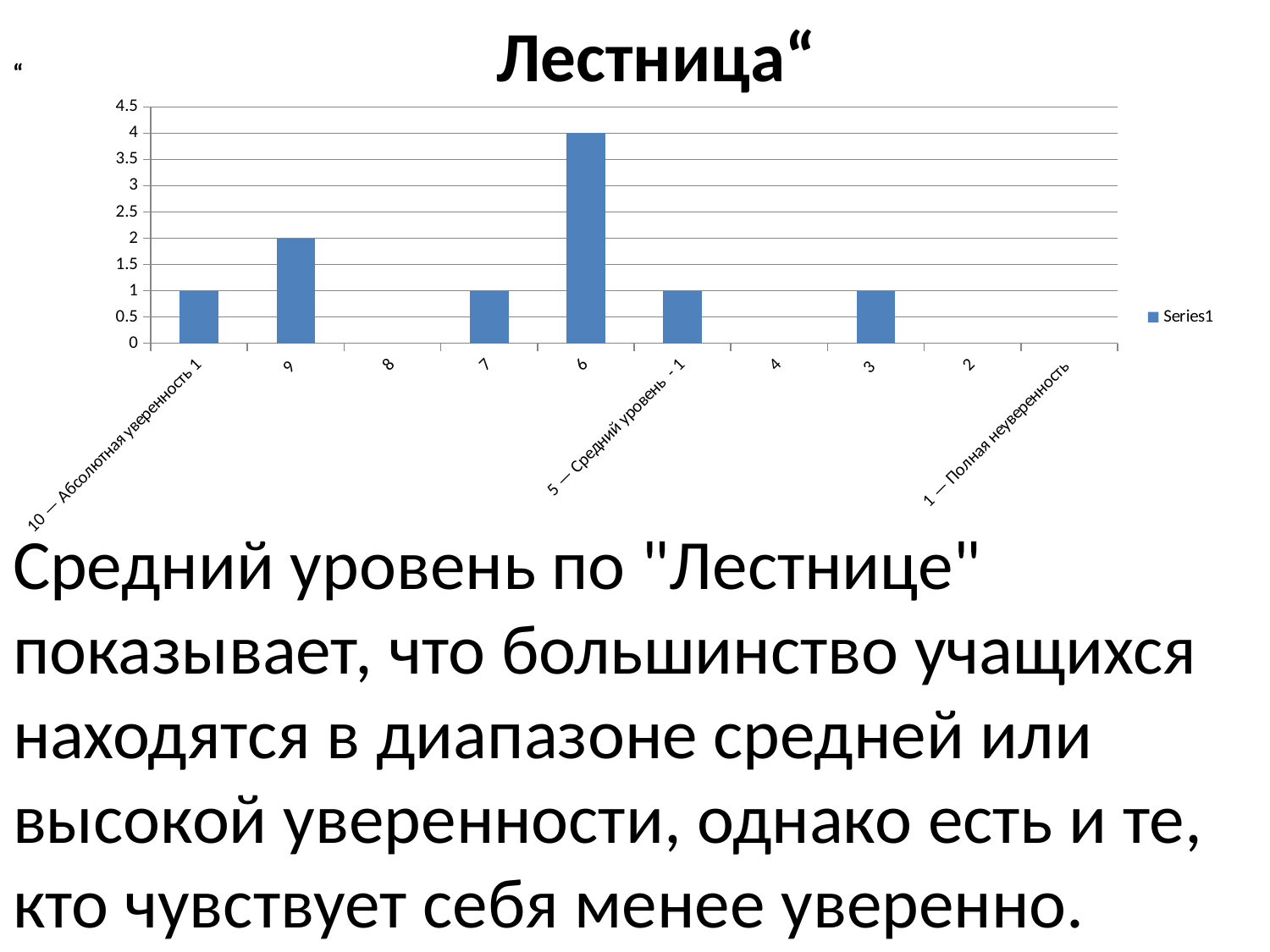
What is the difference between the values for category 6 and category 9? 2 What kind of chart is shown on the slide? bar chart What is the value of the bar for category 7? 1 What is the value of the bar for category 9? 2 What is the value of the bar for category 6? 4 How many series does the legend list? 1 What is the name of the series shown in the legend? Series1 Which category has the highest bar? 6 Which is larger, the value for category 9 or the value for category 7? 9 Is the value for category 6 greater or less than 3? greater What is the value of the bar for category 3? 1 How many categories are shown on the x axis? 10